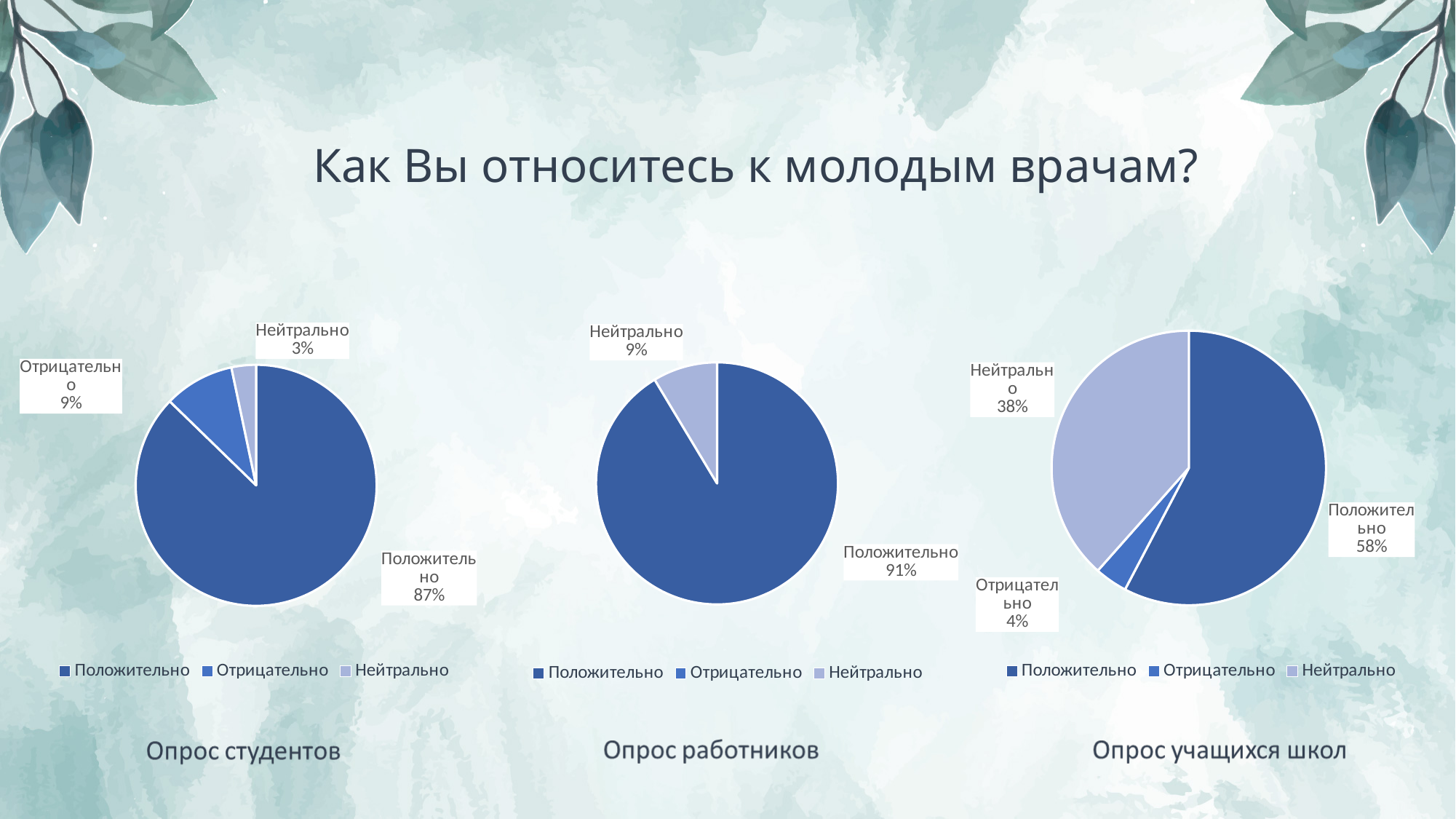
What type of chart is used for 'Опрос работников'? Pie chart In the 'Опрос студентов' chart, what share of respondents answered 'Положительно'? 87% In the 'Опрос студентов' chart, what is the value for 'Нейтрально'? 3% In the 'Опрос учащихся школ' chart, what is the value for 'Отрицательно'? 4% In the 'Опрос учащихся школ' chart, which category has the largest slice? Положительно In the 'Опрос работников' chart, what share is labelled 'Положительно'? 91% In the 'Опрос учащихся школ' chart, what share of respondents answered 'Нейтрально'? 38% In the 'Опрос студентов' chart, which category has the smallest slice? Нейтрально In the 'Опрос работников' chart, what is the value for 'Нейтрально'? 9% How many entries does the legend of the 'Опрос студентов' chart list? 3 In the 'Опрос учащихся школ' chart, what is the difference between 'Положительно' and 'Нейтрально'? 20 percentage points Which is larger: 'Положительно' in the 'Опрос студентов' chart or 'Положительно' in the 'Опрос работников' chart? Опрос работников